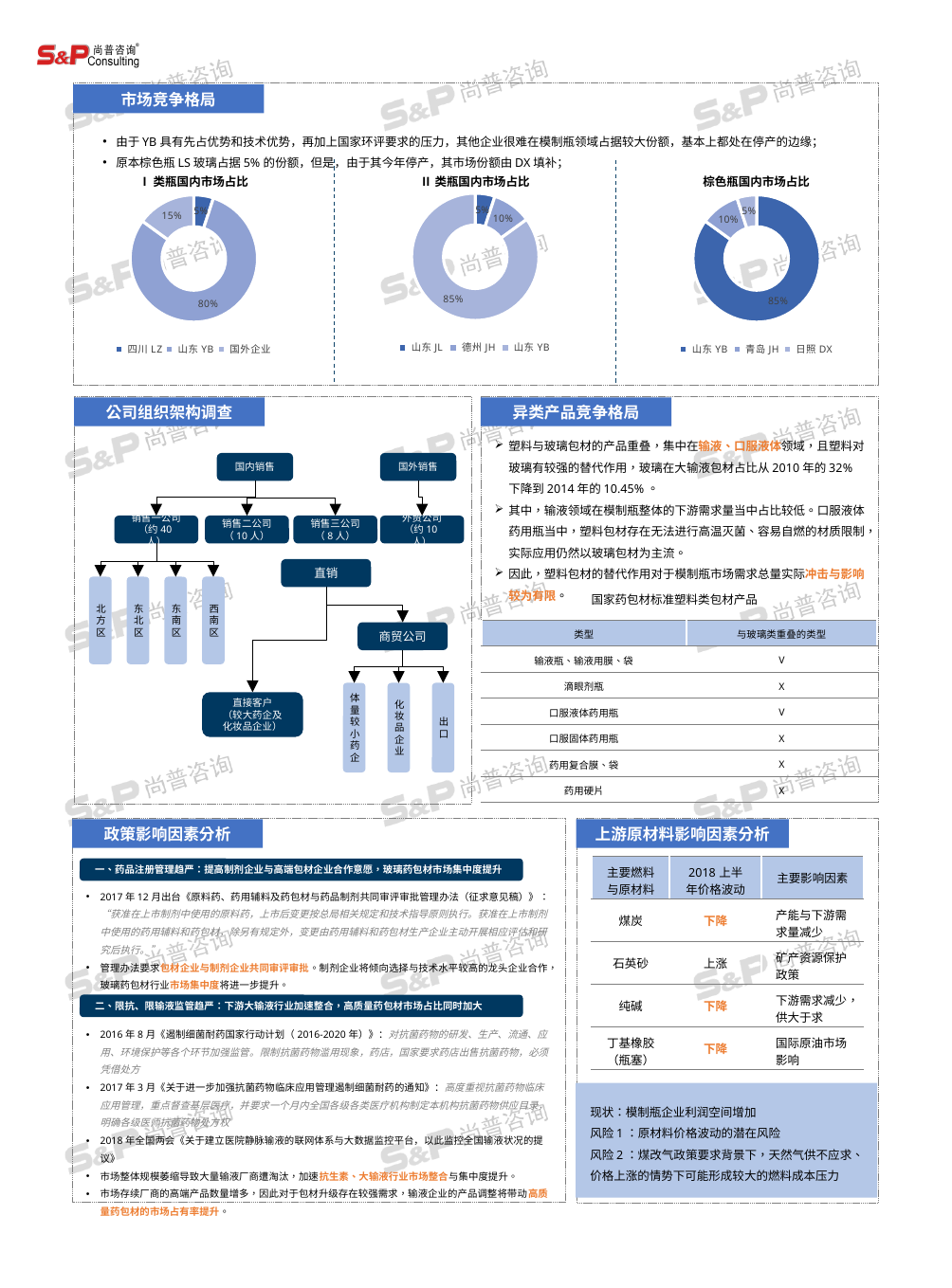
In the 'Ⅱ类瓶国内市场占比' chart, what is the difference between the largest share and the 10% share? 75% In the 'Ⅰ类瓶国内市场占比' chart, what is the largest share shown? 80% Which companies are listed in the legend of the 'Ⅱ类瓶国内市场占比' chart? 山东 JL, 德州 JH, 山东 YB How many legend entries does the '棕色瓶国内市场占比' chart list? 3 In the '棕色瓶国内市场占比' chart, what share does 山东 YB hold? 85% How many pie charts are shown in the '市场竞争格局' section of the slide? 3 In the 'Ⅰ类瓶国内市场占比' chart, what is the smallest share shown? 5% In the 'Ⅰ类瓶国内市场占比' chart, what share does 山东 YB hold? 80% In the 'Ⅱ类瓶国内市场占比' chart, what is the largest share shown? 85% What kind of chart is the 'Ⅰ类瓶国内市场占比' chart? Pie chart (donut) How many slices does the 'Ⅰ类瓶国内市场占比' chart have? 3 In the '棕色瓶国内市场占比' chart, what is the smallest share shown? 5%